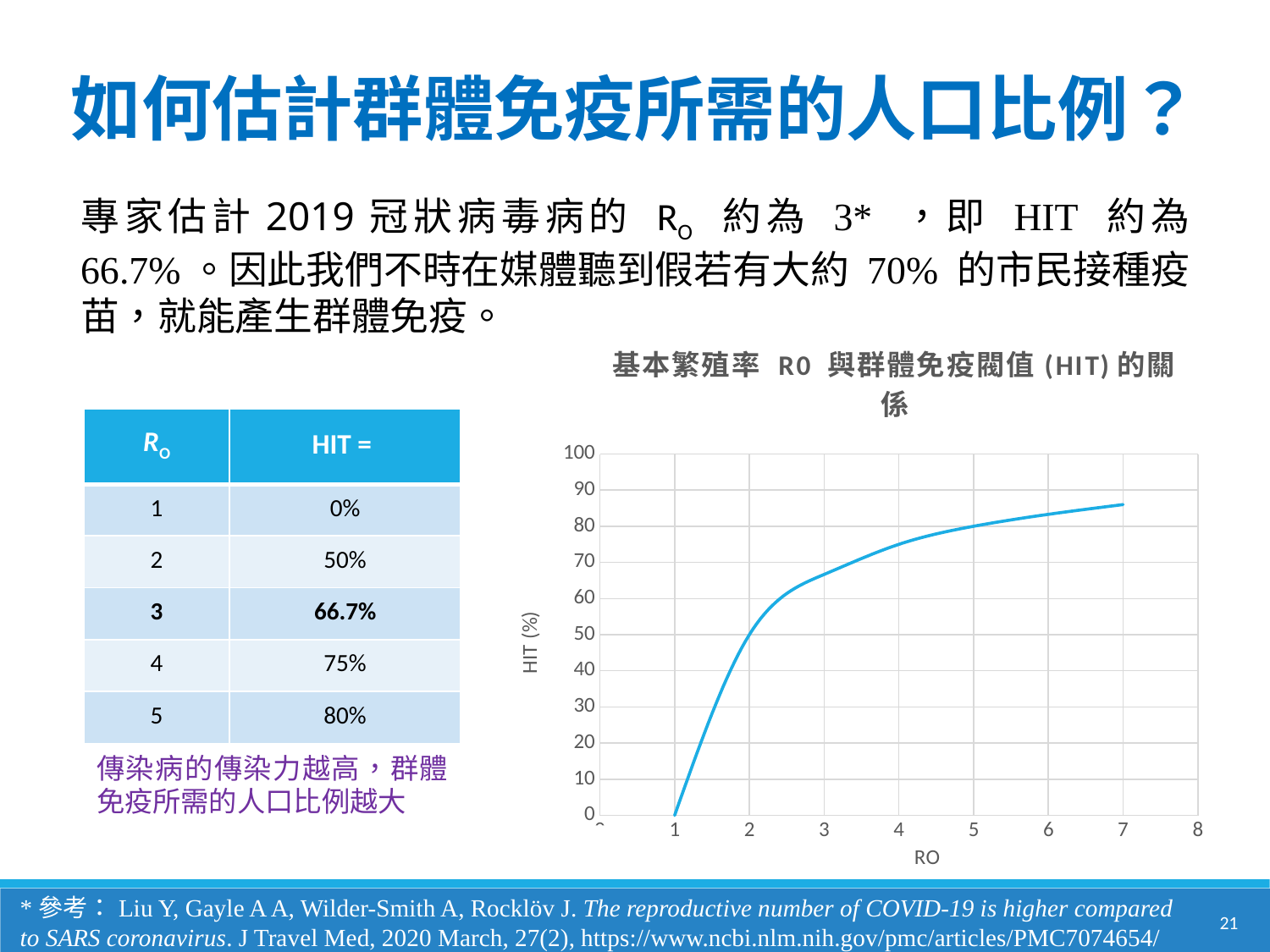
What is the label of the vertical axis of the chart? HIT (%) Which has the larger HIT value on the chart, R0 = 2 or R0 = 5? R0 = 5 Is the HIT value at R0 = 4 greater or less than 70? greater What kind of chart is shown on the slide? line chart Is the HIT value at R0 = 3 greater or less than 60? greater Is the HIT value at R0 = 7 greater or less than 80? greater Does the HIT value rise or fall as R0 increases along the x axis? rises What is the HIT (%) value plotted at R0 = 2? 50 What is the HIT (%) value plotted at R0 = 1? 0 At which plotted R0 value is HIT lowest on the chart? 1 What is the title of the chart? 基本繁殖率 R0 與群體免疫閥值 (HIT) 的關係